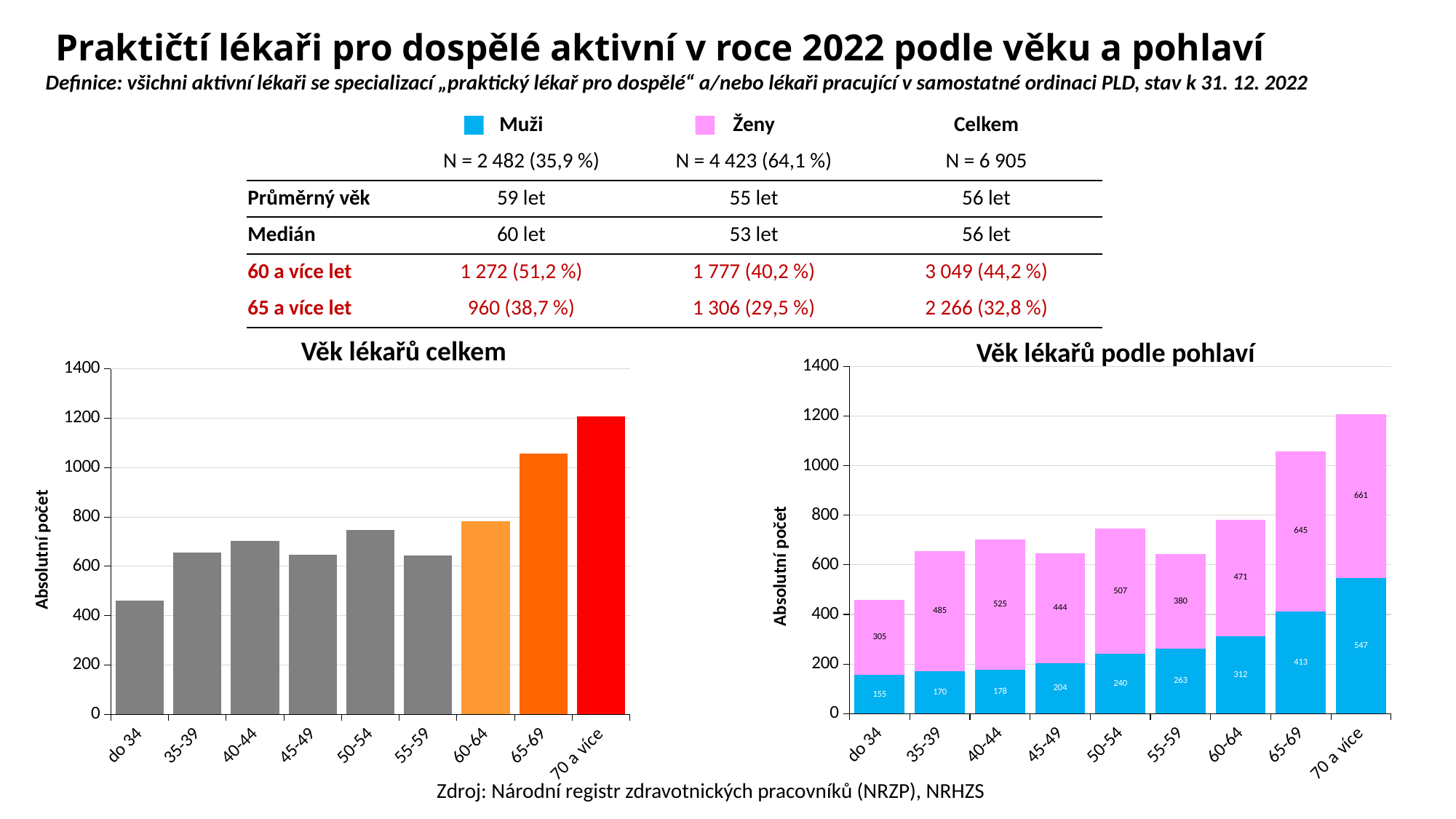
In the chart 'Věk lékařů podle pohlaví', what is the value for Muži in the 70 a více age group? 547 In the chart 'Věk lékařů podle pohlaví', what is the difference between the Ženy and Muži values in the 65-69 age group? 232 In the chart 'Věk lékařů podle pohlaví', what is the value for Muži in the do 34 age group? 155 In the chart 'Věk lékařů celkem', is the value for 65-69 greater or less than 1000? greater How many age groups are shown on the x axis of the chart 'Věk lékařů celkem'? 9 In the chart 'Věk lékařů podle pohlaví', which age group has the highest value for Ženy? 70 a více In the chart 'Věk lékařů podle pohlaví', is the Ženy value for 55-59 larger or smaller than the Ženy value for 50-54? smaller In the chart 'Věk lékařů celkem', is the value for do 34 greater or less than 600? less What type of chart is 'Věk lékařů podle pohlaví'? stacked bar chart In the chart 'Věk lékařů podle pohlaví', which age group has the lowest value for Muži? do 34 In the chart 'Věk lékařů podle pohlaví', what is the value for Ženy in the 40-44 age group? 525 In the chart 'Věk lékařů podle pohlaví', what is the total of the stacked bar for the 60-64 age group? 783